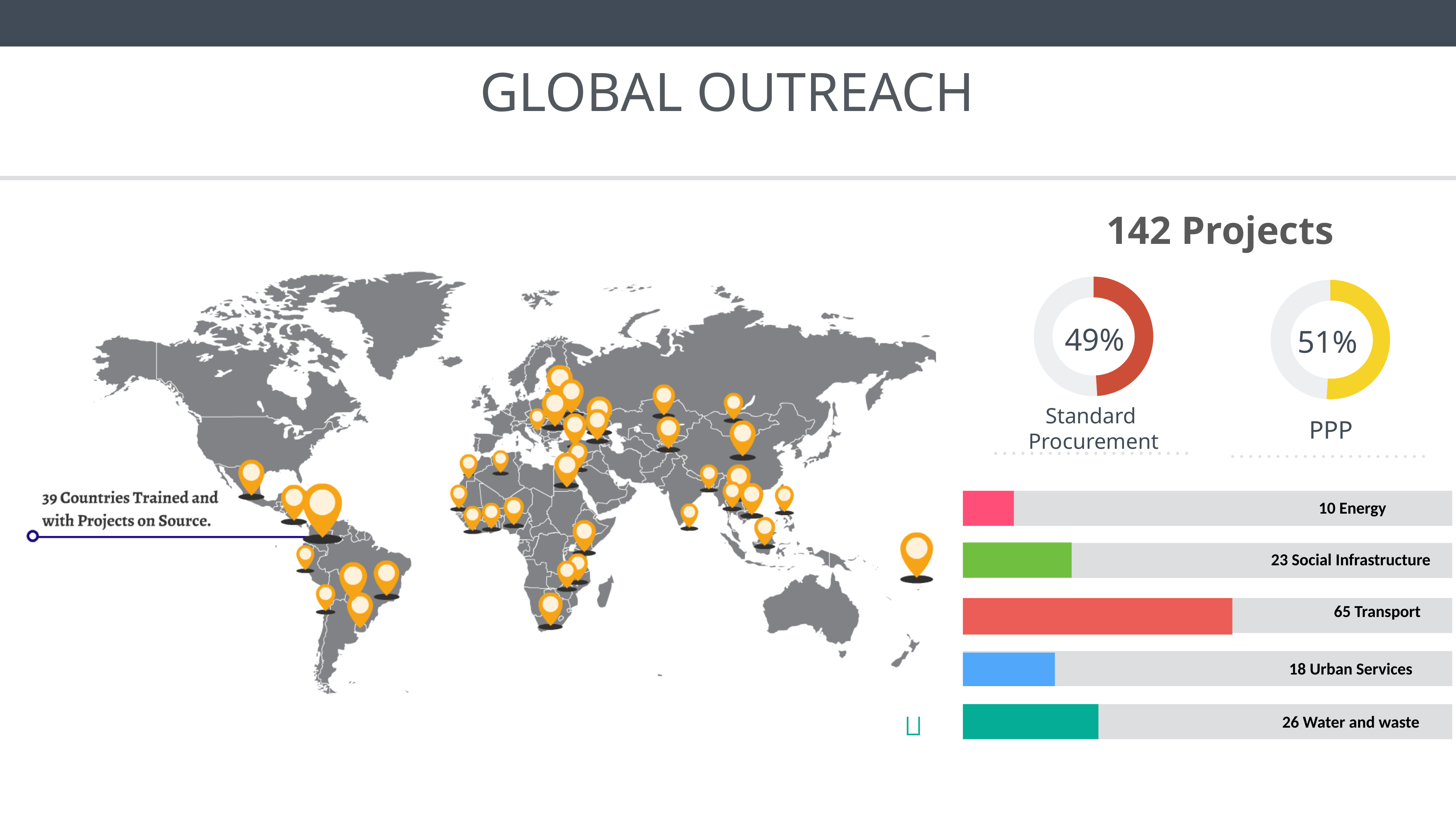
In the bar chart of projects by sector, how many projects are in Transport? 65 In the donut chart labelled Standard Procurement, what percentage is shown? 49% In the bar chart of projects by sector, which sector has the fewest projects? Energy In the bar chart of projects by sector, how many projects are in Water and waste? 26 In the bar chart of projects by sector, which has more projects: Urban Services or Water and waste? Water and waste Which of the two donut charts shows the larger share: Standard Procurement or PPP? PPP How many sectors are shown in the bar chart of projects by sector? 5 In the donut chart labelled PPP, what percentage is shown? 51% What kind of chart shows the projects by sector on the right of the slide? Bar chart In the bar chart of projects by sector, how many projects are in Energy? 10 In the bar chart of projects by sector, which sector has the most projects? Transport In the bar chart of projects by sector, what is the difference between the number of Transport projects and Social Infrastructure projects? 42